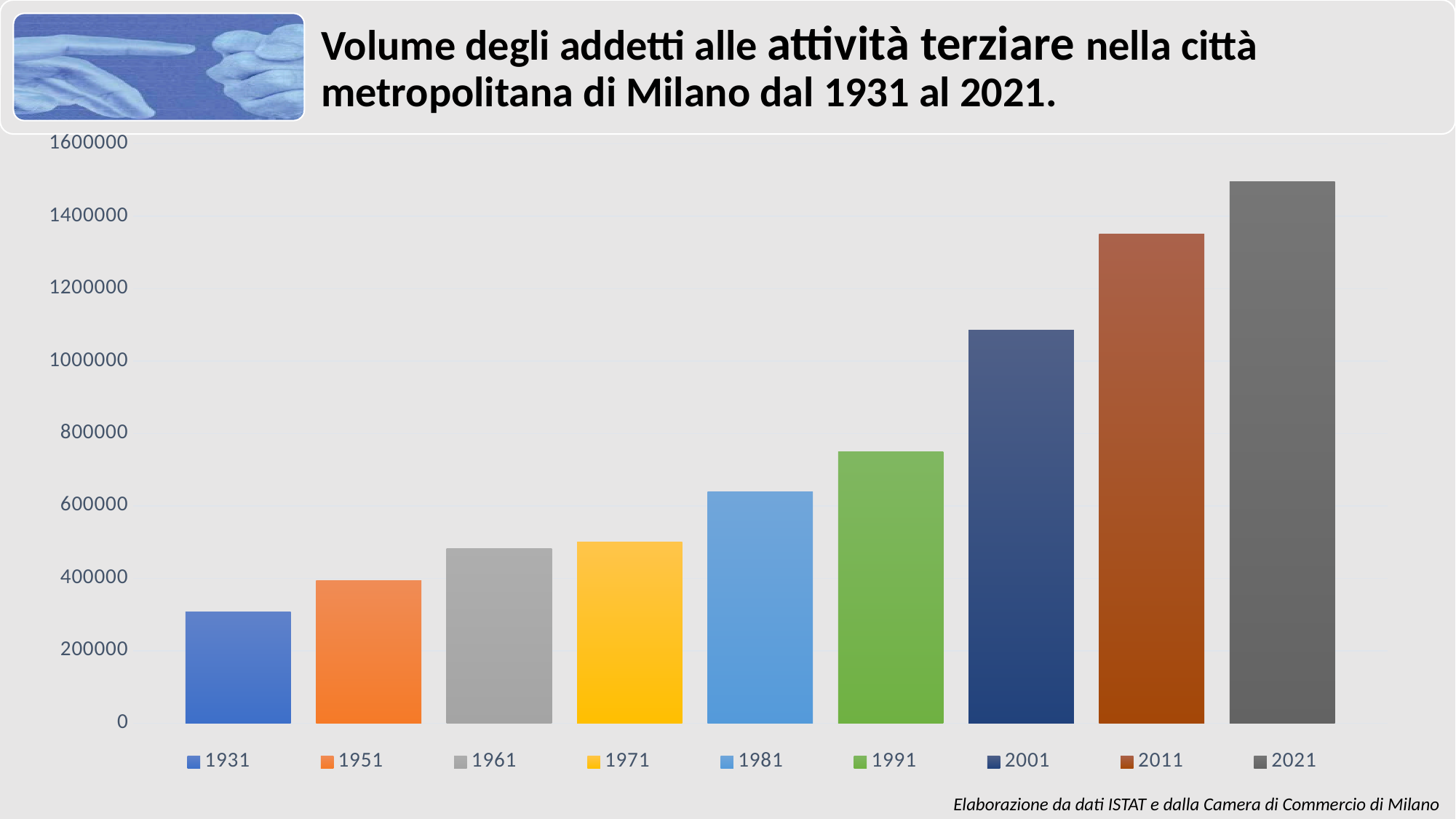
Is the value for 2021 greater or less than 1400000? greater How many bars (years) are plotted in the chart? 9 What kind of chart is shown on the slide? bar chart What is the first year listed in the legend? 1931 Is the value for 1931 greater or less than 400000? less Which year has the lowest value in the chart? 1931 Which year has the highest value in the chart? 2021 How many entries does the legend list? 9 Is the value for 1991 greater or less than 800000? less Do the values rise or fall from 1931 to 2021 along the x axis? rise Which is larger, the value for 2001 or the value for 1991? 2001